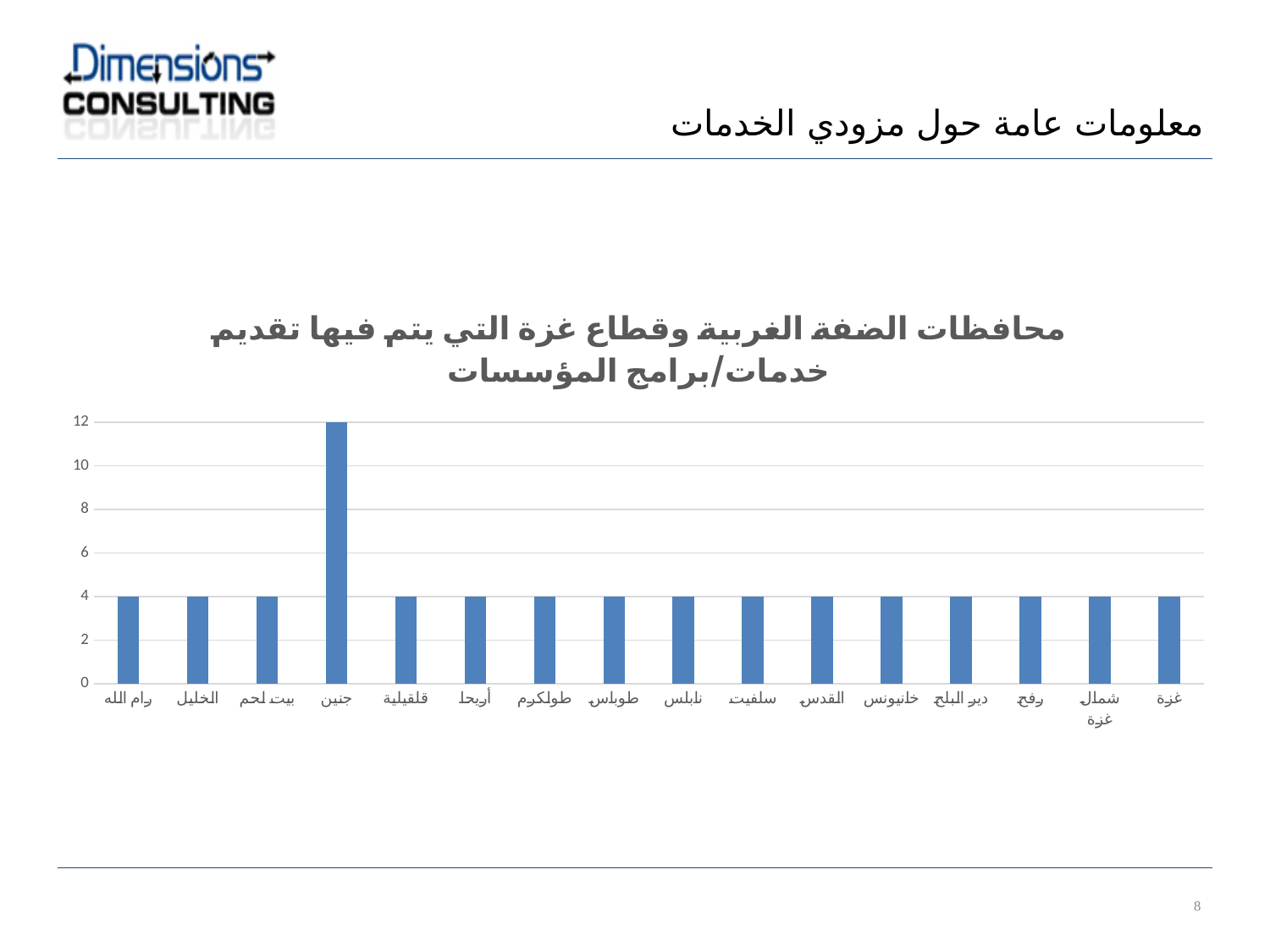
What is the title of the chart? محافظات الضفة الغربية وقطاع غزة التي يتم فيها تقديم خدمات/برامج المؤسسات What kind of chart is shown on the slide? bar chart What is the value for رام الله? 4 Is the value for القدس greater or less than 6? less Is the value for جنين greater or less than 10? greater What is the value for غزة? 4 How many governorates (categories) are shown on the x axis? 16 What is the highest value shown on the vertical axis? 12 Which is larger, the value for جنين or the value for نابلس? جنين What is the value for جنين? 12 Which governorate has the highest value in the chart? جنين What is the difference between the value for جنين and the value for الخليل? 8